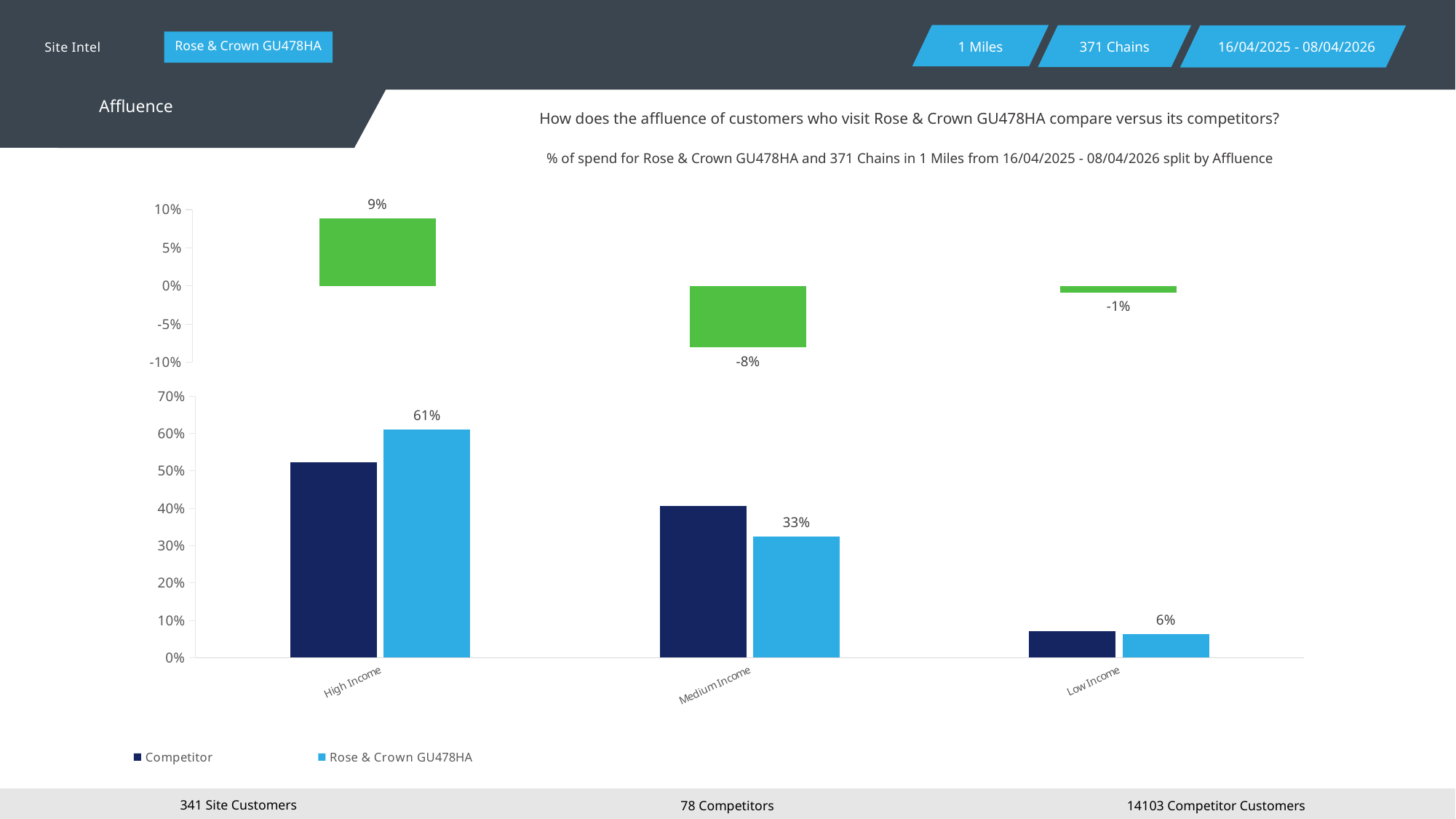
How many series does the legend of the bottom bar chart list? 2 In the bottom bar chart, what is the value for Rose & Crown GU478HA in the High Income category? 61% In the bottom bar chart, is the Competitor value for Medium Income greater or less than 50%? less In the bottom bar chart, is the Competitor value for High Income greater or less than 50%? greater In the top green chart, which category has the lowest value? Medium Income In the bottom bar chart, what is the value for Rose & Crown GU478HA in the Low Income category? 6% In the bottom bar chart, what is the value for Rose & Crown GU478HA in the Medium Income category? 33% In the bottom bar chart, which category has the highest value for Rose & Crown GU478HA? High Income In the bottom bar chart, what is the difference between the Rose & Crown GU478HA values for High Income and Medium Income? 28% In the bottom bar chart, which is larger for Medium Income: the Competitor value or the Rose & Crown GU478HA value? Competitor In the top green chart, what is the value shown for High Income? 9% In the top green chart, what is the value shown for Medium Income? -8%